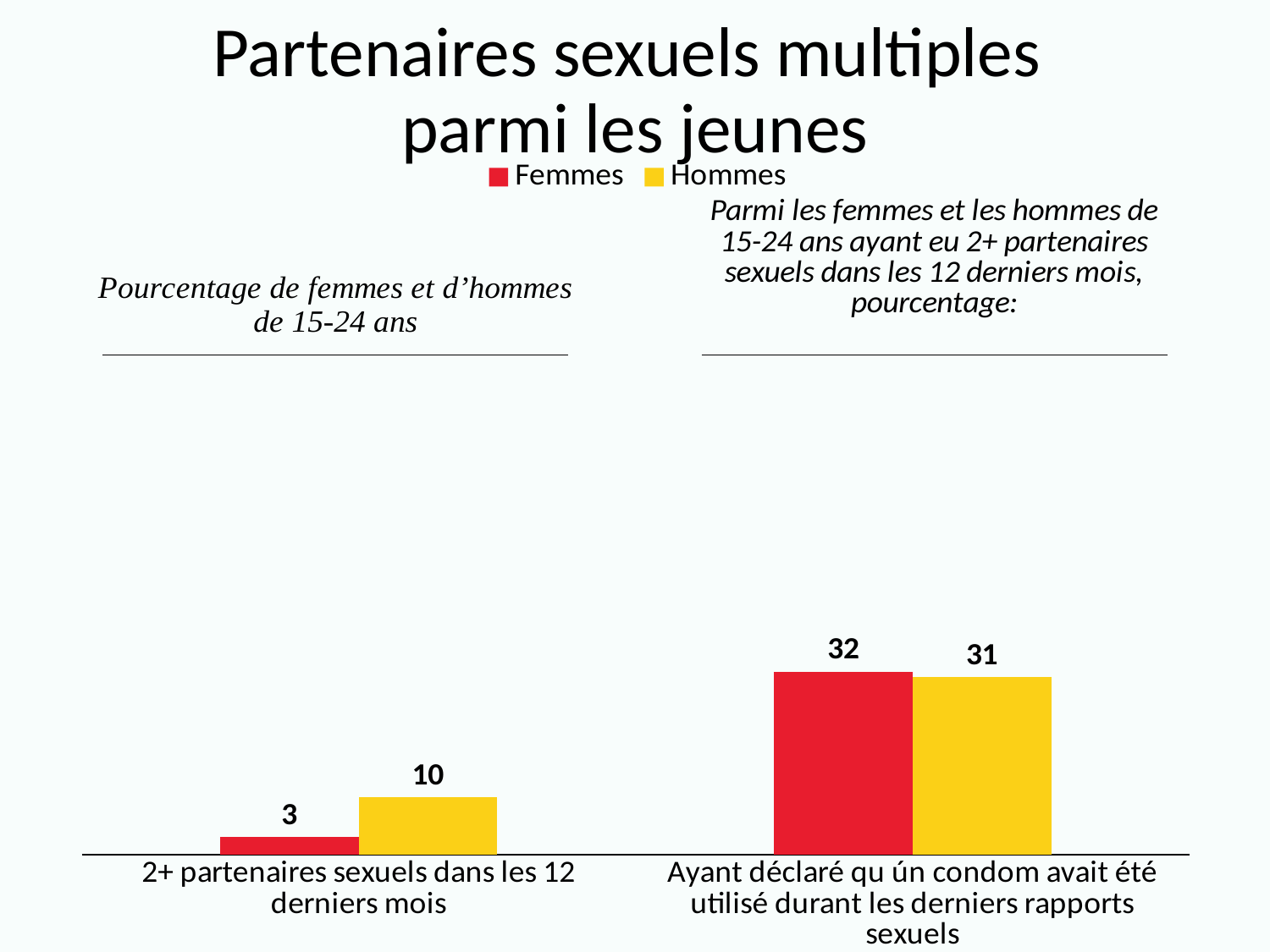
How many categories are shown on the x axis? 2 What kind of chart is shown on the slide? Bar chart What is the value for Hommes in the category 'Ayant déclaré qu ún condom avait été utilisé durant les derniers rapports sexuels'? 31 What is the value for Hommes in the category '2+ partenaires sexuels dans les 12 derniers mois'? 10 What is the value for Femmes in the category '2+ partenaires sexuels dans les 12 derniers mois'? 3 Which bar has the lowest value on the chart? Femmes, 2+ partenaires sexuels dans les 12 derniers mois What is the difference between the Hommes and Femmes values in the category '2+ partenaires sexuels dans les 12 derniers mois'? 7 Which series has the higher value in the category '2+ partenaires sexuels dans les 12 derniers mois'? Hommes What is the value for Femmes in the category 'Ayant déclaré qu ún condom avait été utilisé durant les derniers rapports sexuels'? 32 What is the difference between the Femmes and Hommes values in the category 'Ayant déclaré qu ún condom avait été utilisé durant les derniers rapports sexuels'? 1 How many series does the legend list? 2 What colour represents the Femmes series? Red